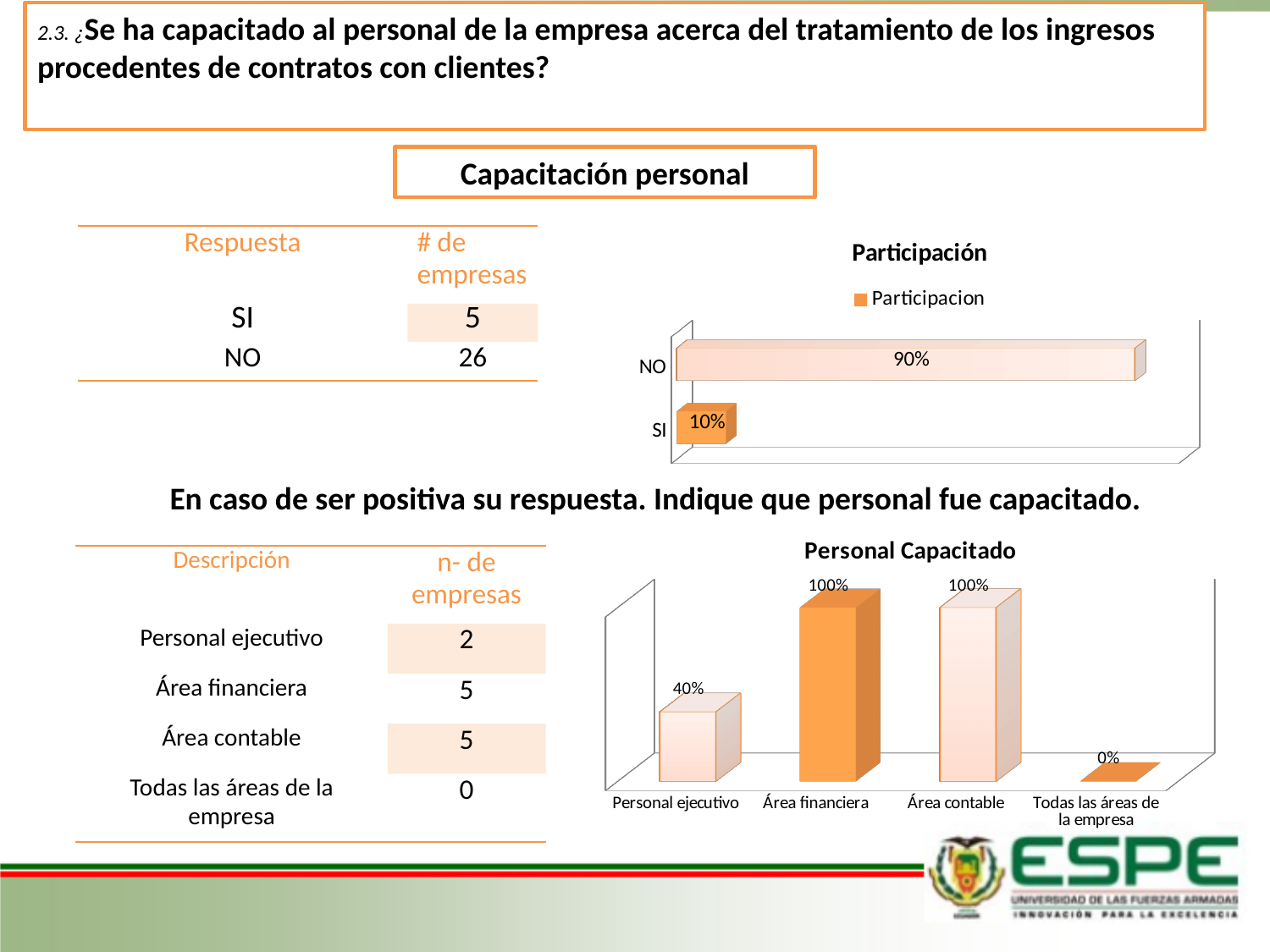
In the 'Participación' chart, how many categories are plotted? 2 In the 'Participación' chart, how many series does the legend list? 1 In the 'Participación' chart, what is the value for NO? 90% In the 'Personal Capacitado' chart, which category has the lowest value? Todas las áreas de la empresa In the 'Personal Capacitado' chart, what is the value for Personal ejecutivo? 40% What kind of chart is the 'Participación' chart? Bar chart In the 'Personal Capacitado' chart, what is the difference between Área contable and Personal ejecutivo? 60% In the 'Personal Capacitado' chart, how many categories are plotted? 4 In the 'Participación' chart, what is the value for SI? 10% In the 'Personal Capacitado' chart, what is the value for Área financiera? 100% In the 'Personal Capacitado' chart, which is larger, Personal ejecutivo or Área contable? Área contable In the 'Participación' chart, what is the difference between the NO and SI values? 80%